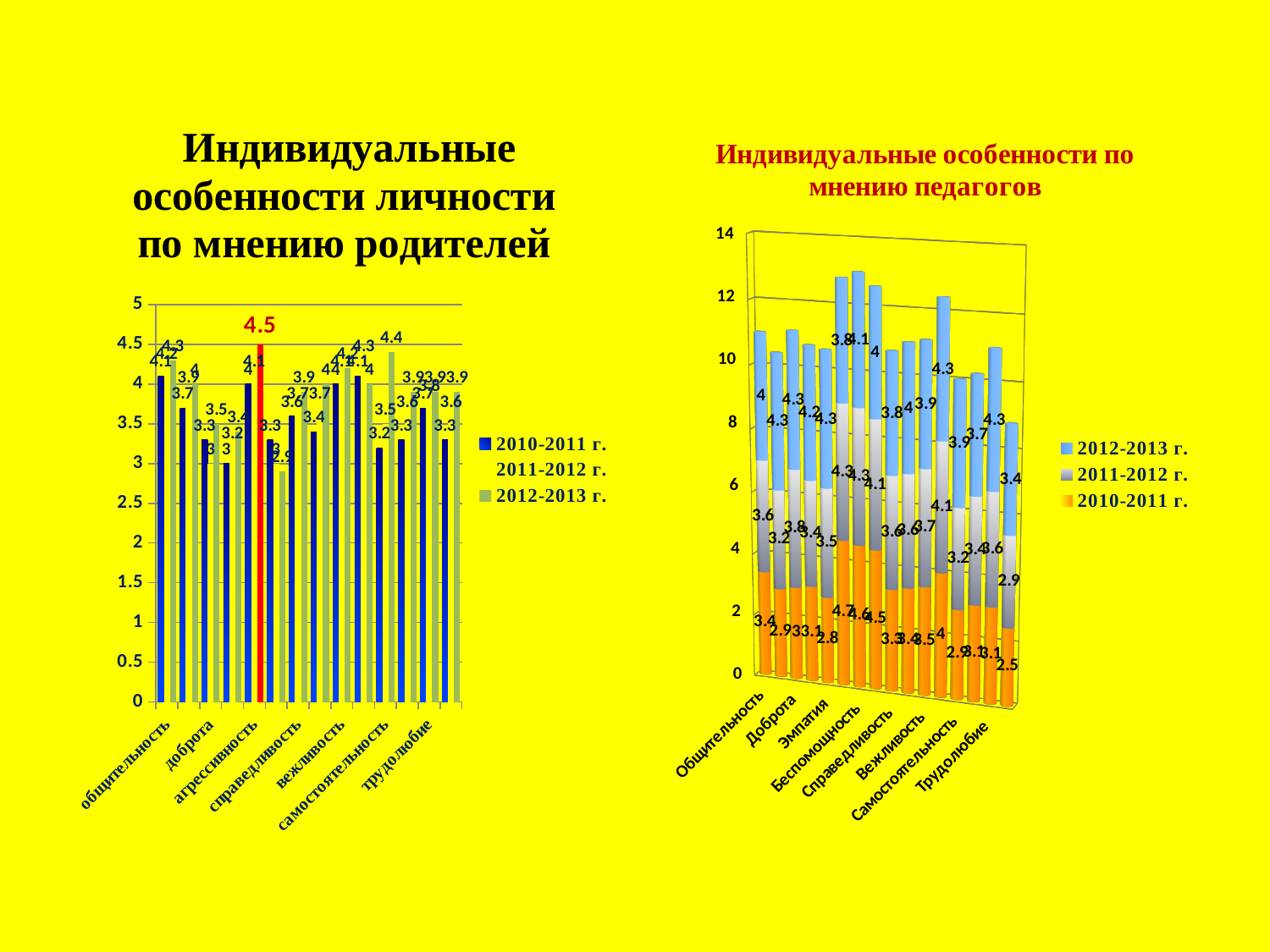
In the right chart ('по мнению педагогов'), is the total of the tallest bar for Беспомощность greater or less than 12? greater In the left chart ('по мнению родителей'), what is the highest value shown? 4.5 In the left chart ('по мнению родителей'), what colour is the bar labelled 4.5? red How many series does the legend of the right chart ('по мнению педагогов') list? 3 How many series does the legend of the left chart ('по мнению родителей') list? 3 How many category labels are shown on the x axis of the left chart ('по мнению родителей')? 7 What kind of chart is the right chart, 'Индивидуальные особенности по мнению педагогов'? stacked bar chart How many category labels are shown on the x axis of the right chart ('по мнению педагогов')? 8 What kind of chart is the left chart, 'Индивидуальные особенности личности по мнению родителей'? bar chart In the right chart ('по мнению педагогов'), which series forms the bottom (orange) segment of each stacked bar? 2010-2011 г.